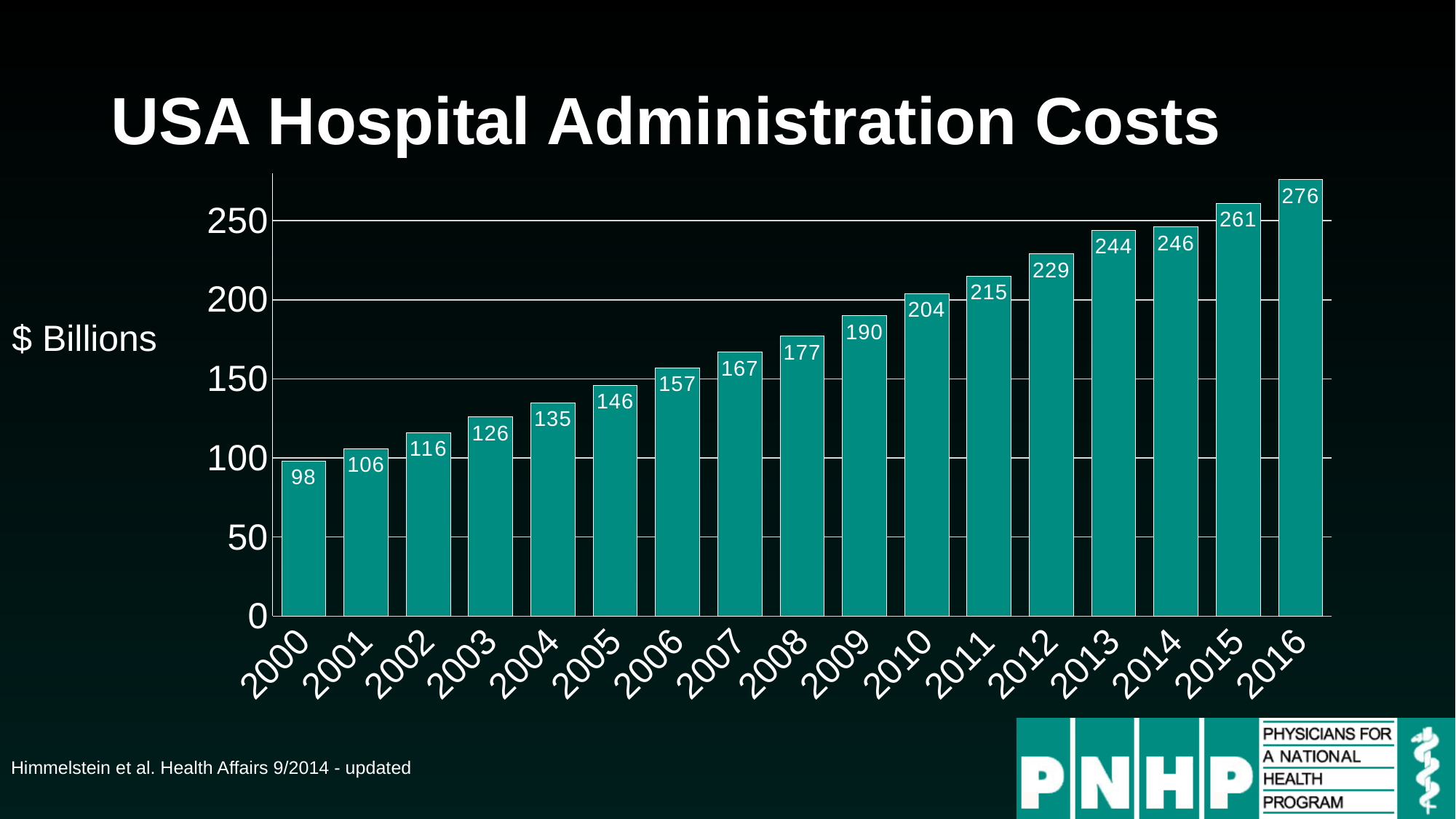
What kind of chart is this? bar chart What is the difference between the values for 2013 and 2012? 15 What is the difference between the values for 2016 and 2000? 178 Which year has the highest value? 2016 What is the value for 2000? 98 Is the value for 2010 greater or less than 200? greater Do the values rise or fall from 2000 to 2016? rise Which year has the lowest value? 2000 What is the value for 2008? 177 What is the value for 2016? 276 How many years are shown on the x axis? 17 Which is larger, the value for 2005 or the value for 2009? 2009